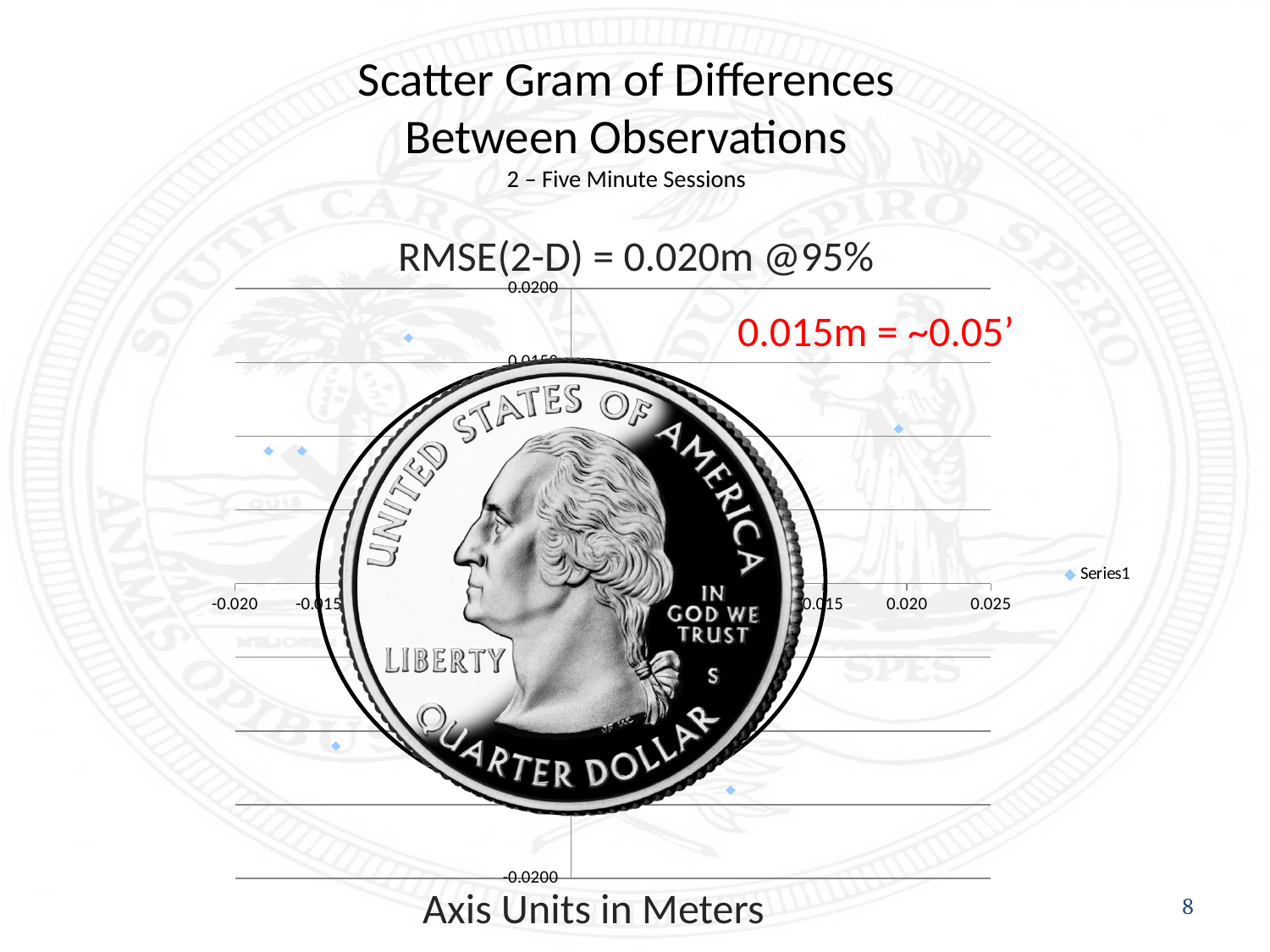
How many series does the chart legend list? 1 What kind of chart is shown on the slide? scatter chart Is the y value of the highest plotted point greater or less than 0.0200? less Is the x value of the leftmost plotted point greater or less than -0.015? less What is the name of the series shown in the chart legend? Series1 Is the x value of the rightmost plotted point greater or less than 0.015? greater